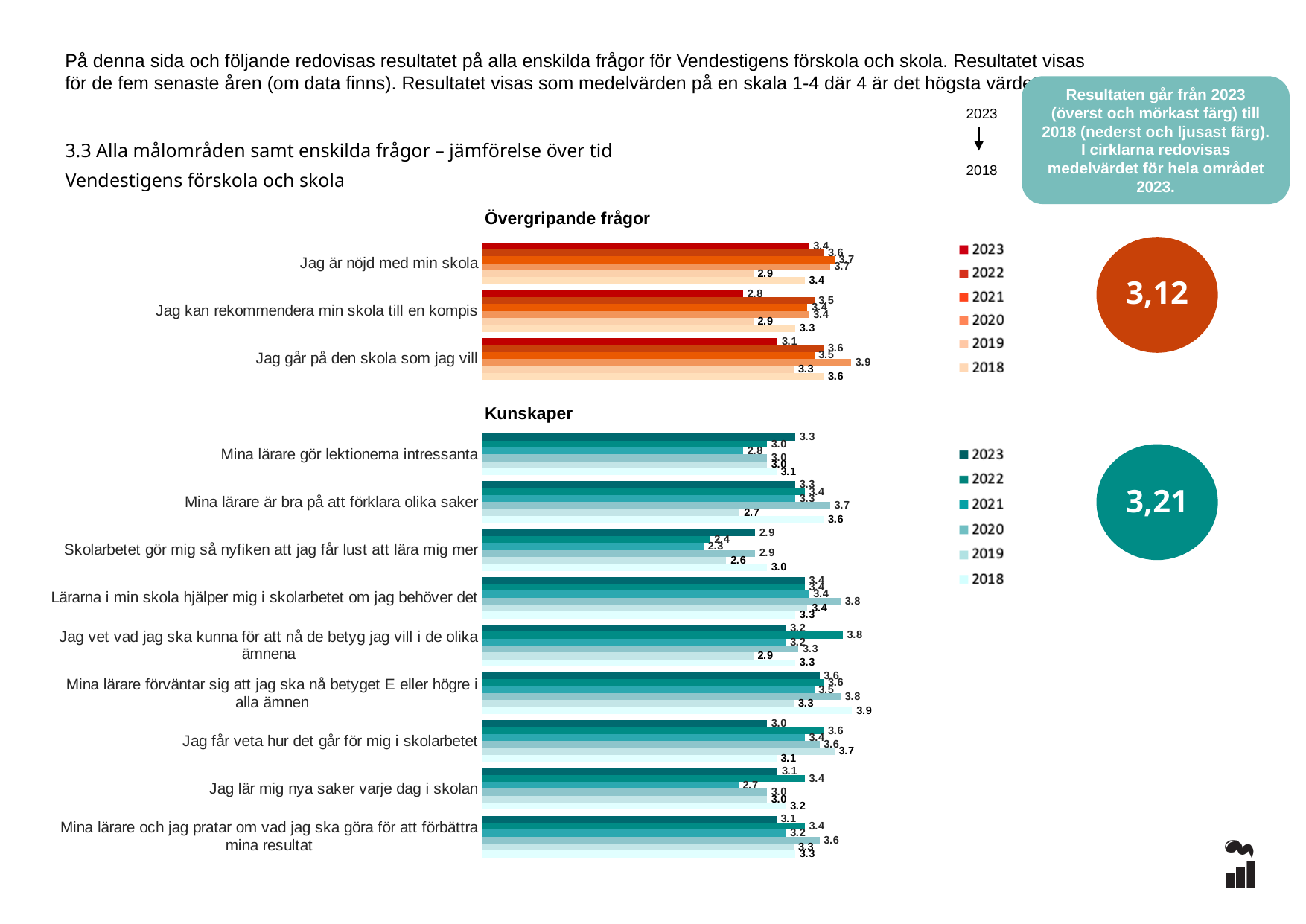
In the Övergripande frågor chart, what is the difference between the 2022 and 2023 values for "Jag kan rekommendera min skola till en kompis"? 0.7 In the Övergripande frågor chart, what is the 2020 value for "Jag går på den skola som jag vill"? 3.9 How many questions (categories) are shown in the Kunskaper chart? 9 In the Övergripande frågor chart, what is the 2019 value for "Jag är nöjd med min skola"? 2.9 In the Kunskaper chart, what is the 2018 value for "Mina lärare förväntar sig att jag ska nå betyget E eller högre i alla ämnen"? 3.9 In the Kunskaper chart, what is the 2022 value for "Jag vet vad jag ska kunna för att nå de betyg jag vill i de olika ämnena"? 3.8 In the Kunskaper chart, what is the 2023 value for "Mina lärare gör lektionerna intressanta"? 3.3 In the Övergripande frågor chart, what is the 2023 value for "Jag kan rekommendera min skola till en kompis"? 2.8 How many series does the legend of the Övergripande frågor chart list? 6 In the Kunskaper chart, which question has the lowest 2023 value? Skolarbetet gör mig så nyfiken att jag får lust att lära mig mer What is the overall 2023 mean value shown in the circle next to the Kunskaper chart? 3,21 In the Kunskaper chart, which is larger for "Jag får veta hur det går för mig i skolarbetet": the 2023 value or the 2019 value? 2019